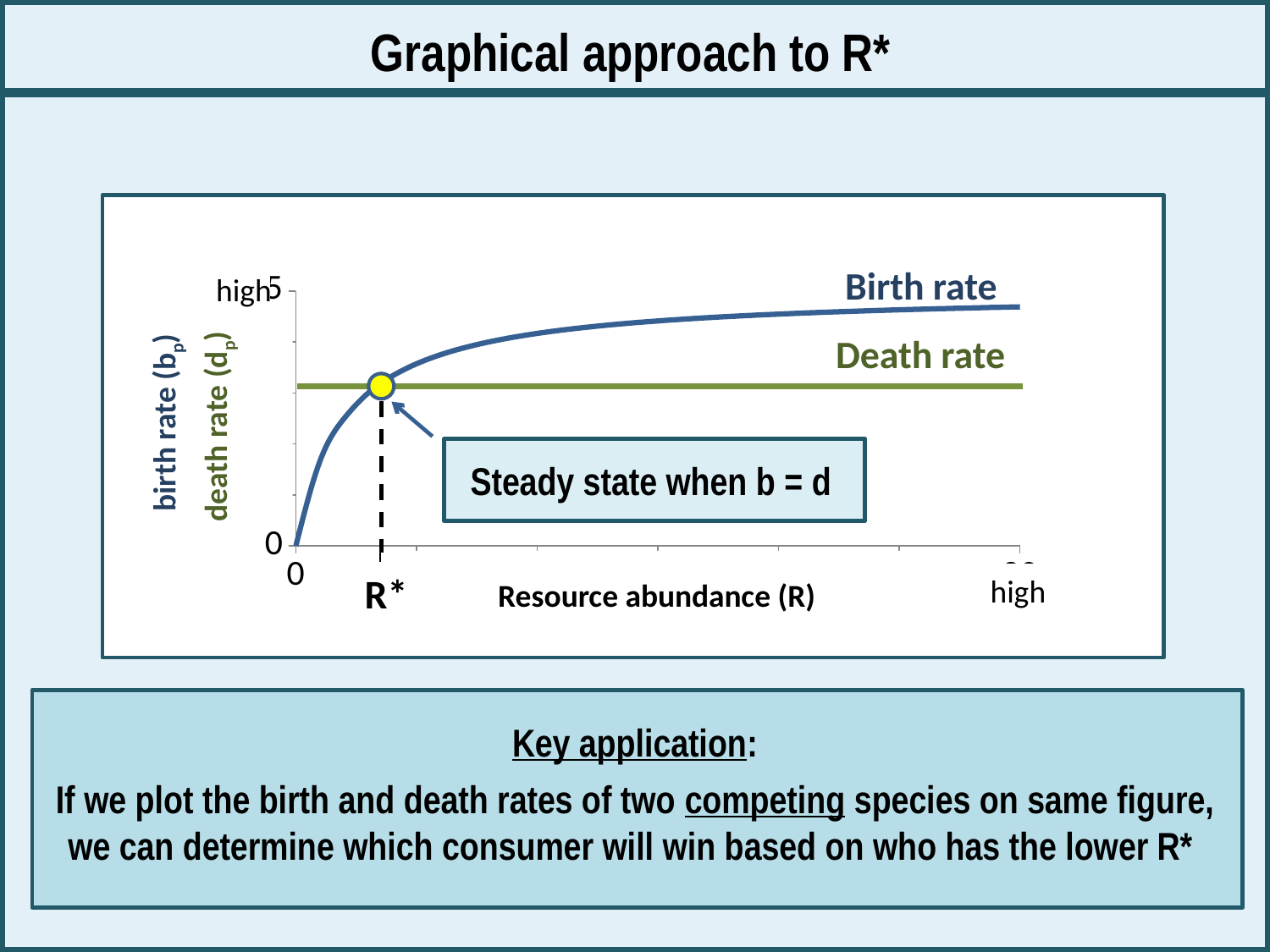
What is the lowest value shown on the y axis of the chart? 0 What value of resource abundance is marked on the x axis where the Birth rate and Death rate curves intersect? R* At resource abundance just above 0, which is larger: the Birth rate or the Death rate? Death rate What are the two series plotted on the chart? Birth rate and Death rate Does the Death rate line rise, fall, or stay flat as resource abundance (R) increases? Stays flat What is the label on the x axis of the chart? Resource abundance (R) According to the callout on the chart, when does the steady state occur? When b = d Does the Birth rate curve rise or fall as resource abundance (R) increases? Rises At high resource abundance, which is larger: the Birth rate or the Death rate? Birth rate What is the highest numeric tick shown on the y axis of the chart? 5 How many series are plotted on the chart? 2 What kind of chart is shown on the slide? Line chart